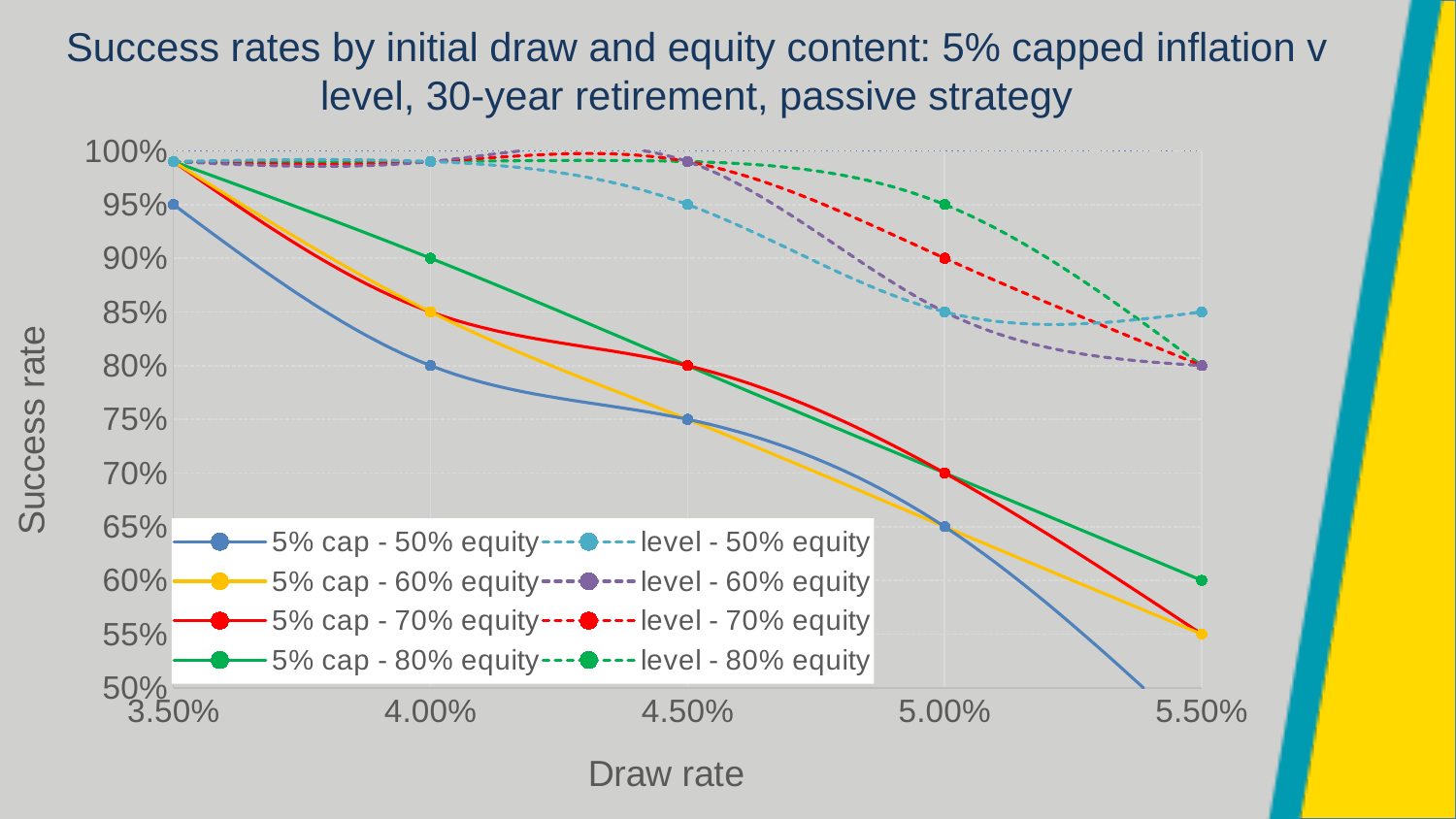
What is the label on the vertical axis of the chart? Success rate What is the success rate for 'level - 70% equity' at a 5.00% draw rate? 90% At a 4.00% draw rate, what is the difference in success rate between '5% cap - 80% equity' and '5% cap - 50% equity'? 10 percentage points What is the success rate for '5% cap - 80% equity' at a 4.00% draw rate? 90% How many series does the legend list? 8 What type of chart is shown on the slide? Line chart At a 5.50% draw rate, which has the higher success rate: 'level - 50% equity' or 'level - 60% equity'? level - 50% equity Does the success rate for '5% cap - 70% equity' rise or fall as the draw rate increases? Fall What is the success rate for '5% cap - 60% equity' at a 5.50% draw rate? 55% What is the success rate for '5% cap - 50% equity' at a 4.00% draw rate? 80% Is the success rate for '5% cap - 50% equity' at a 5.50% draw rate greater or less than 55%? less How many draw rate values are shown on the x axis? 5